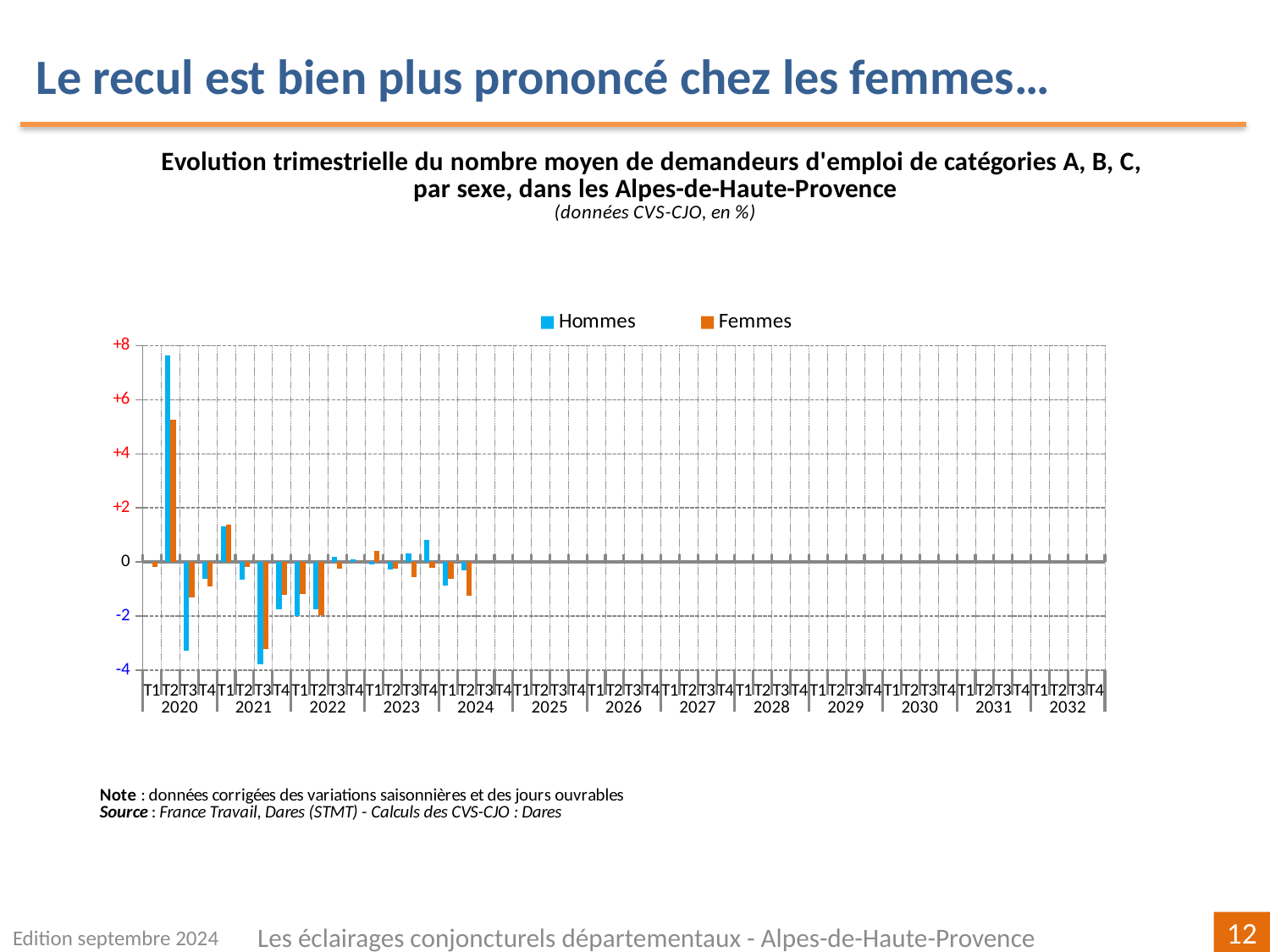
In which quarter does the Hommes series reach its lowest value? T3 2021 How many series does the legend list? 2 Is the Femmes value for T2 2020 greater or less than +4? greater In T2 2020, which series has the higher value, Hommes or Femmes? Hommes Is the Hommes value for T2 2020 greater or less than +6? greater In T3 2020, which series has the higher value, Hommes or Femmes? Femmes What kind of chart is shown on the slide? Bar chart Which colour represents the Femmes series? Orange Which two series are listed in the legend? Hommes and Femmes In which quarter does the Femmes series reach its lowest value? T3 2021 In which quarter does the Hommes series reach its highest value? T2 2020 Is the Hommes value for T3 2021 greater or less than -2? less